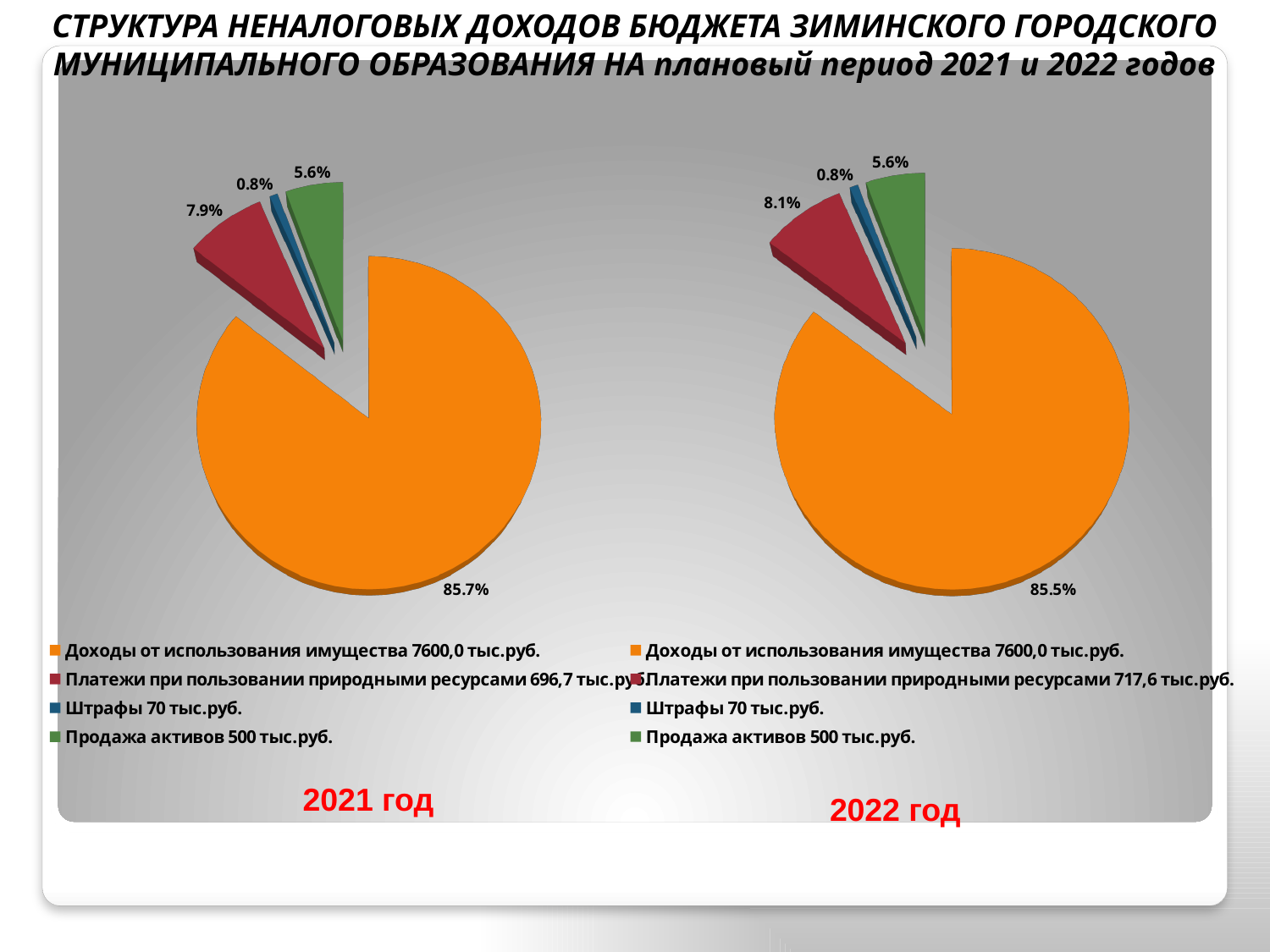
In the 2022 год pie chart, what share is shown for Штрафы? 0.8% In the 2022 год pie chart, what share is shown for Доходы от использования имущества? 85.5% In the 2022 год pie chart, what share is shown for Платежи при пользовании природными ресурсами? 8.1% In the 2022 год pie chart, which category has the smallest slice? Штрафы What is the difference between the share for Платежи при пользовании природными ресурсами in the 2022 год chart and in the 2021 год chart? 0.2% How many slices does the 2021 год pie chart have? 4 In the 2021 год pie chart, which category has the largest slice? Доходы от использования имущества What type of chart is used for the 2022 год data? Pie chart In the 2022 год pie chart, which is larger: the slice for Платежи при пользовании природными ресурсами or the slice for Продажа активов? Платежи при пользовании природными ресурсами